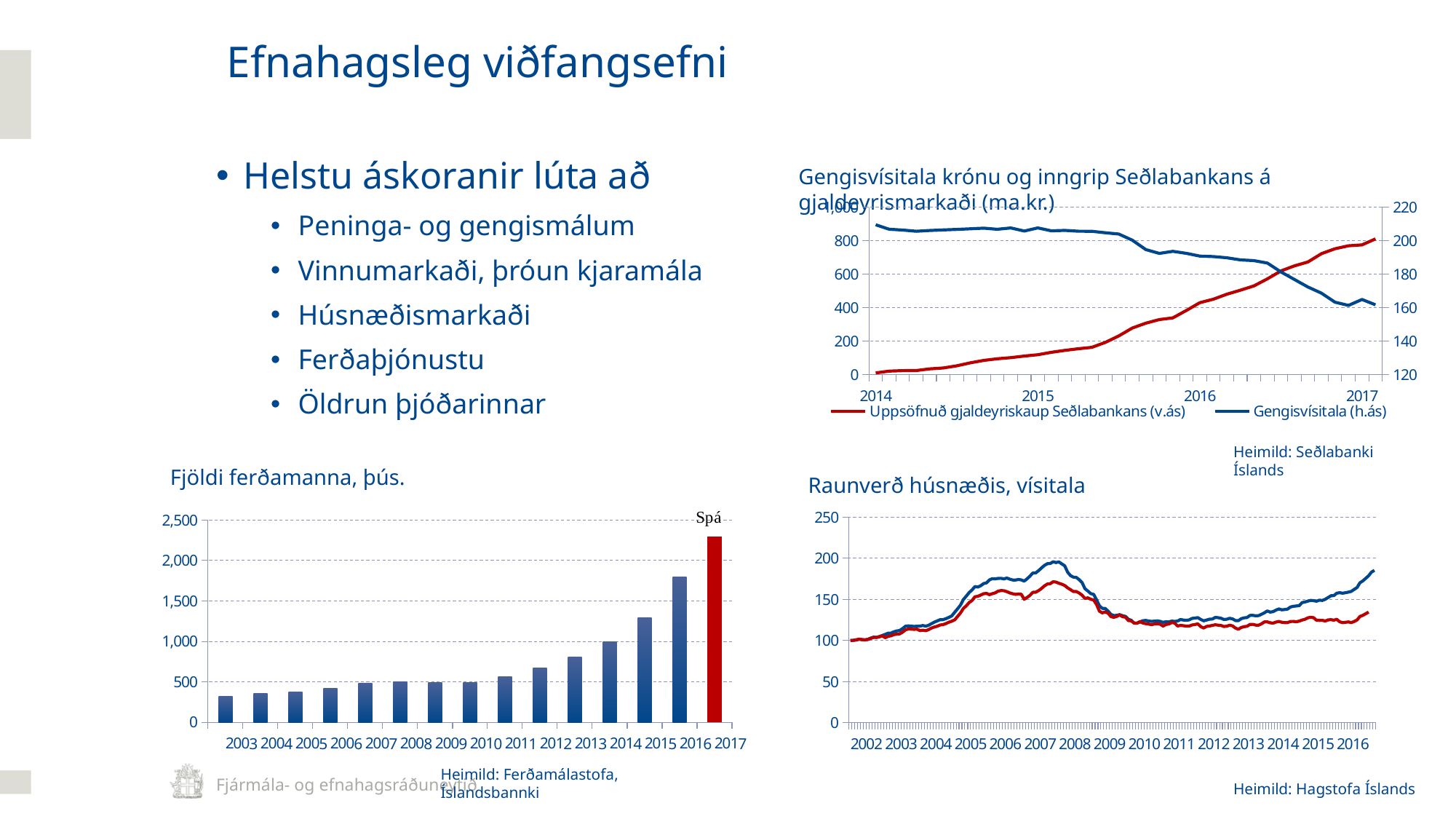
In the 'Fjöldi ferðamanna, þús.' chart, which is larger, the value for 2015 or the value for 2012? 2015 In the 'Fjöldi ferðamanna, þús.' chart, how many years are shown on the x axis? 15 In the 'Gengisvísitala krónu og inngrip Seðlabankans á gjaldeyrismarkaði (ma.kr.)' chart, does the 'Uppsöfnuð gjaldeyriskaup Seðlabankans (v.ás)' line rise or fall from 2014 to 2017? rise In the 'Fjöldi ferðamanna, þús.' chart, is the value for 2017 greater or less than 2,000? greater In the 'Fjöldi ferðamanna, þús.' chart, do the values generally rise or fall from 2003 to 2017? rise In the 'Fjöldi ferðamanna, þús.' chart, is the value for 2003 greater or less than 500? less What kind of chart is the 'Fjöldi ferðamanna, þús.' chart? bar chart In the 'Fjöldi ferðamanna, þús.' chart, which year has the highest bar? 2017 In the 'Fjöldi ferðamanna, þús.' chart, which year has the lowest bar? 2003 In the 'Fjöldi ferðamanna, þús.' chart, which bar is coloured red? 2017 What kind of chart is the 'Raunverð húsnæðis, vísitala' chart? line chart How many series does the legend of the 'Gengisvísitala krónu og inngrip Seðlabankans á gjaldeyrismarkaði (ma.kr.)' chart list? 2